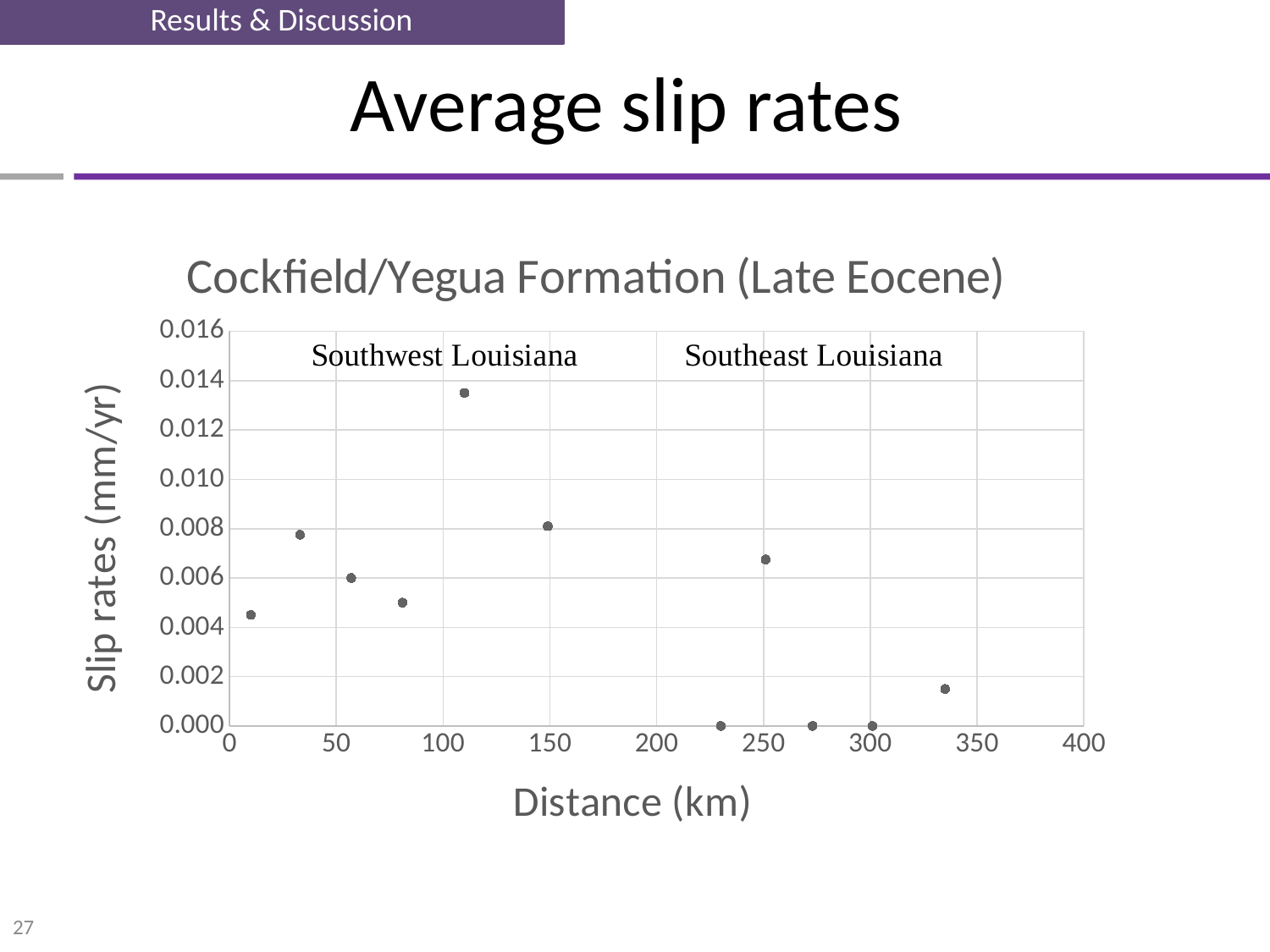
How many data points are plotted on the chart? 11 How many data points are plotted at distances greater than 200 km? 5 What kind of chart is shown on the slide? Scatter chart Which has the higher slip rate: the point plotted near 10 km or the point plotted near 33 km? The point near 33 km Is the slip rate of the highest point on the chart greater or less than 0.012 mm/yr? greater Is the slip rate of the point plotted near 10 km greater or less than 0.006 mm/yr? less What is the title of the chart? Cockfield/Yegua Formation (Late Eocene) Is the slip rate of the point plotted near 250 km greater or less than 0.006 mm/yr? greater What is the label of the y axis of the chart? Slip rates (mm/yr) Which has the higher slip rate: the point plotted near 110 km or the point plotted near 150 km? The point near 110 km